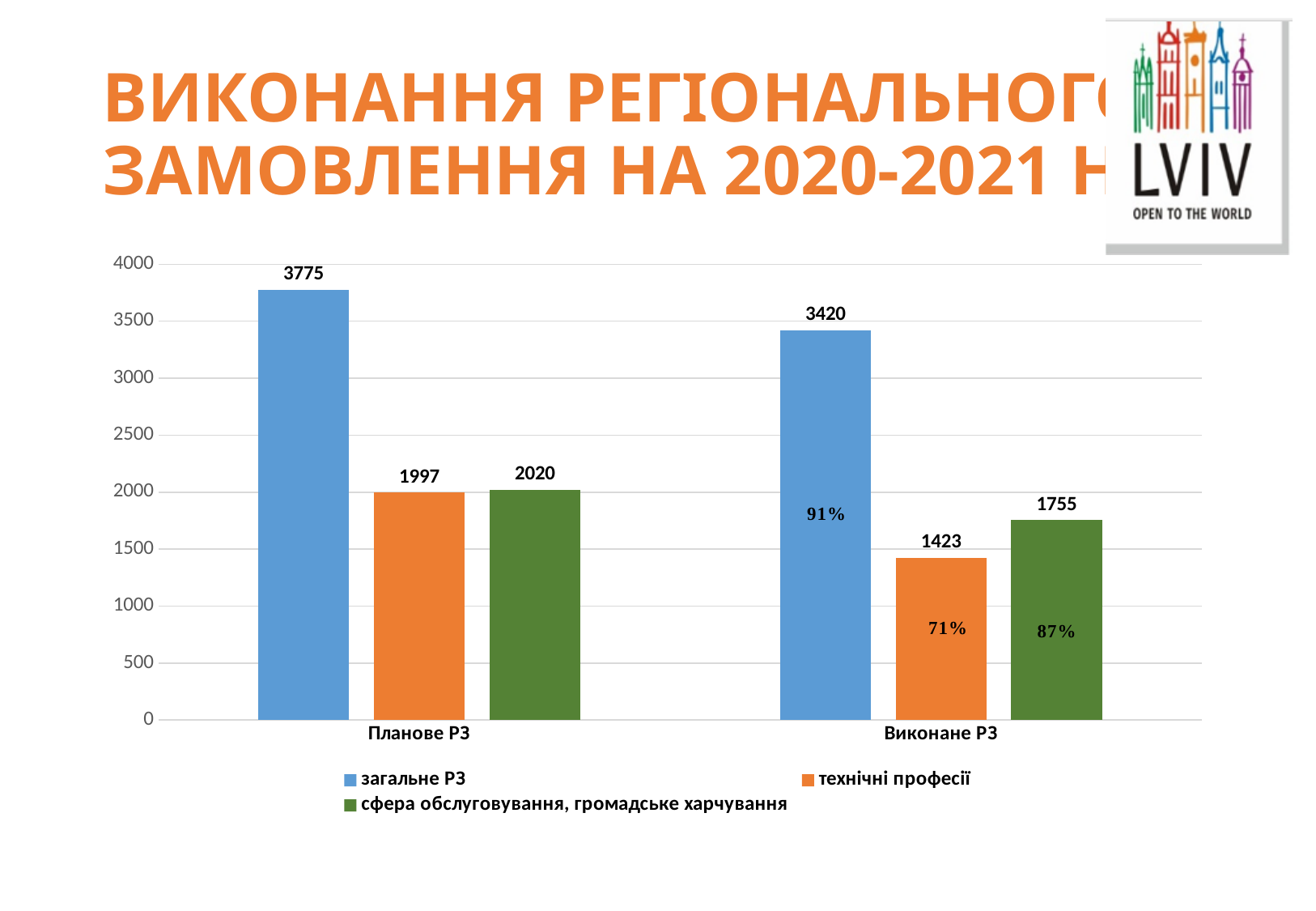
What is the value of сфера обслуговування, громадське харчування for Планове РЗ? 2020 What percentage is printed inside the загальне РЗ bar for Виконане РЗ? 91% What percentage is printed inside the сфера обслуговування, громадське харчування bar for Виконане РЗ? 87% Which series has the lowest value for Виконане РЗ? технічні професії Which series has the highest value for Виконане РЗ? загальне РЗ What is the value of загальне РЗ for Планове РЗ? 3775 What is the difference between загальне РЗ for Планове РЗ and for Виконане РЗ? 355 What kind of chart is shown on the slide? bar chart Which is larger: технічні професії for Планове РЗ or for Виконане РЗ? Планове РЗ How many series does the legend list? 3 What colour are the технічні професії bars? orange What is the value of технічні професії for Виконане РЗ? 1423